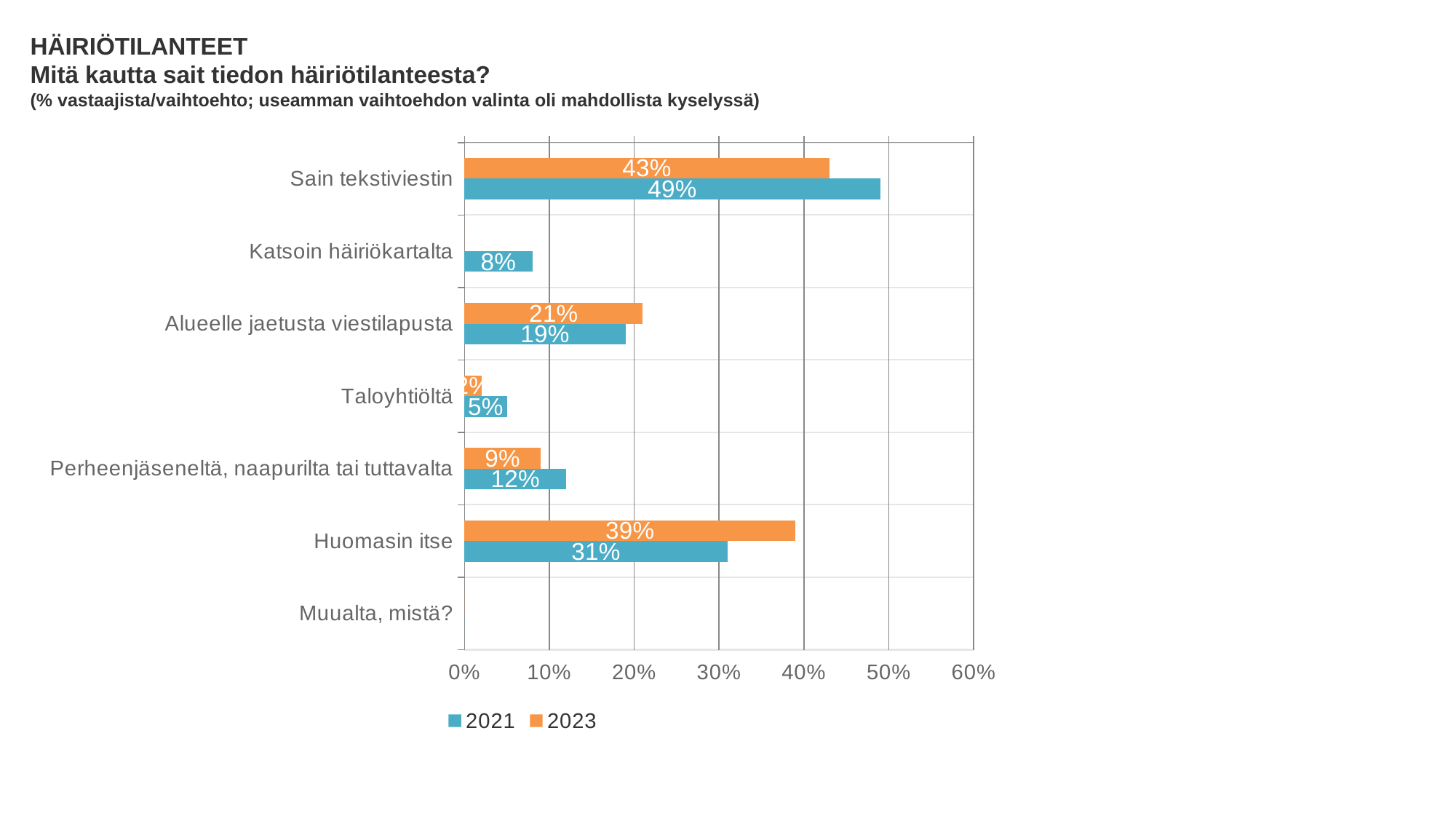
What kind of chart is shown on the slide? Bar chart Which category has the highest 2021 value? Sain tekstiviestin For "Perheenjäseneltä, naapurilta tai tuttavalta", which year has the larger value, 2021 or 2023? 2021 Is the 2021 value for "Sain tekstiviestin" greater or less than 40%? greater What is the difference between the 2021 and 2023 values for "Huomasin itse"? 8% How many series does the legend list? 2 What is the 2021 value for "Sain tekstiviestin"? 49% What is the 2021 value for "Katsoin häiriökartalta"? 8% How many categories are listed on the vertical axis of the chart? 7 What is the 2023 value for "Huomasin itse"? 39% Which category has the highest 2023 value? Sain tekstiviestin What is the 2023 value for "Alueelle jaetusta viestilapusta"? 21%